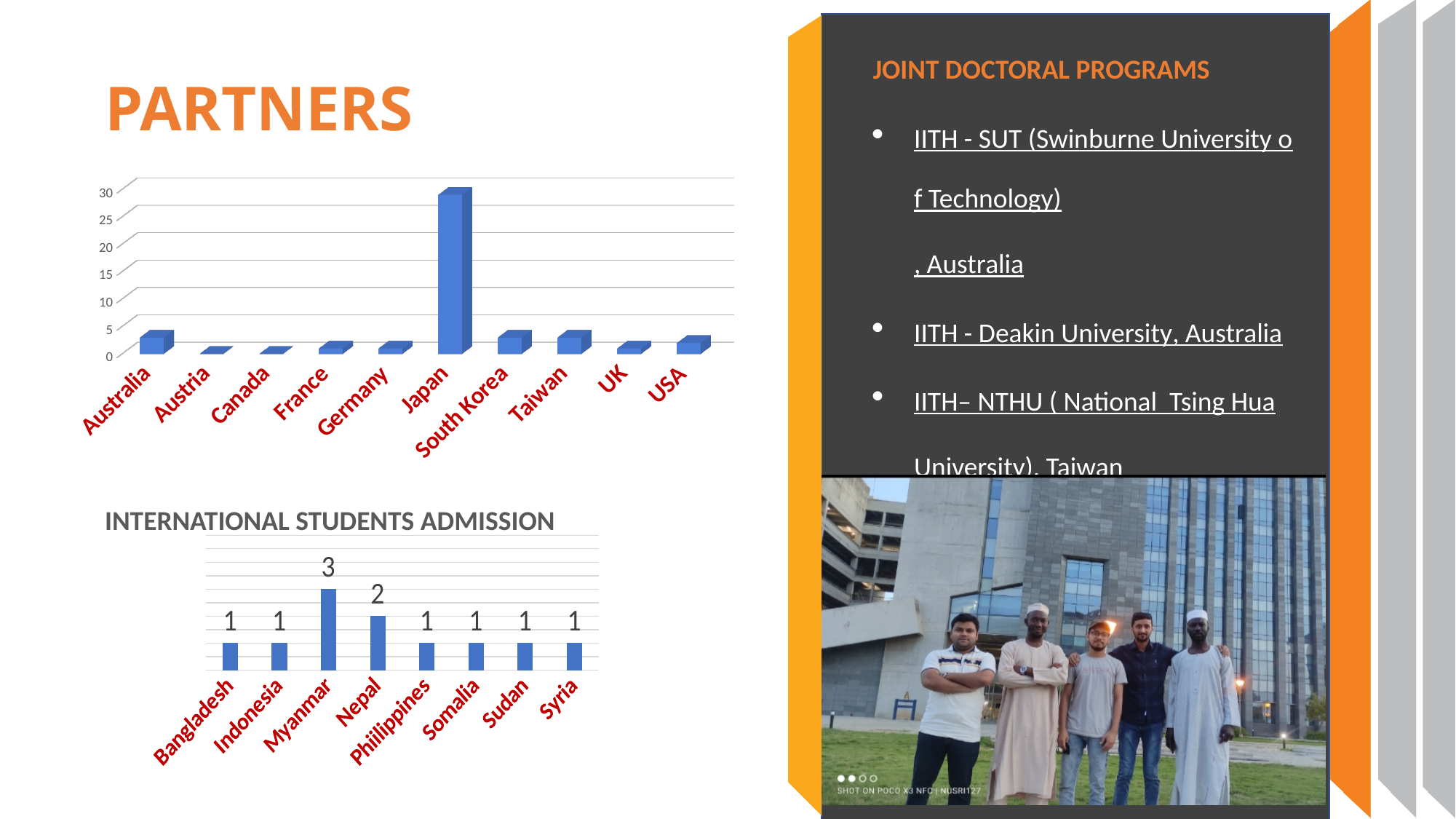
What is the title of the bar chart at the bottom left of the slide? INTERNATIONAL STUDENTS ADMISSION In the INTERNATIONAL STUDENTS ADMISSION chart, what is the value for Nepal? 2 In the INTERNATIONAL STUDENTS ADMISSION chart, what is the value for Myanmar? 3 In the INTERNATIONAL STUDENTS ADMISSION chart, what is the difference between the values for Myanmar and Nepal? 1 In the PARTNERS chart at the top left, which country has the highest bar? Japan In the INTERNATIONAL STUDENTS ADMISSION chart, which country has the highest value? Myanmar How many countries are shown on the x axis of the PARTNERS chart at the top left? 10 What kind of chart is the PARTNERS chart at the top left? Bar chart In the PARTNERS chart at the top left, is the value for Australia greater or less than 10? less In the INTERNATIONAL STUDENTS ADMISSION chart, which is larger, the value for Nepal or the value for Sudan? Nepal In the PARTNERS chart at the top left, is the value for Japan greater or less than 25? greater How many countries are shown in the INTERNATIONAL STUDENTS ADMISSION chart? 8